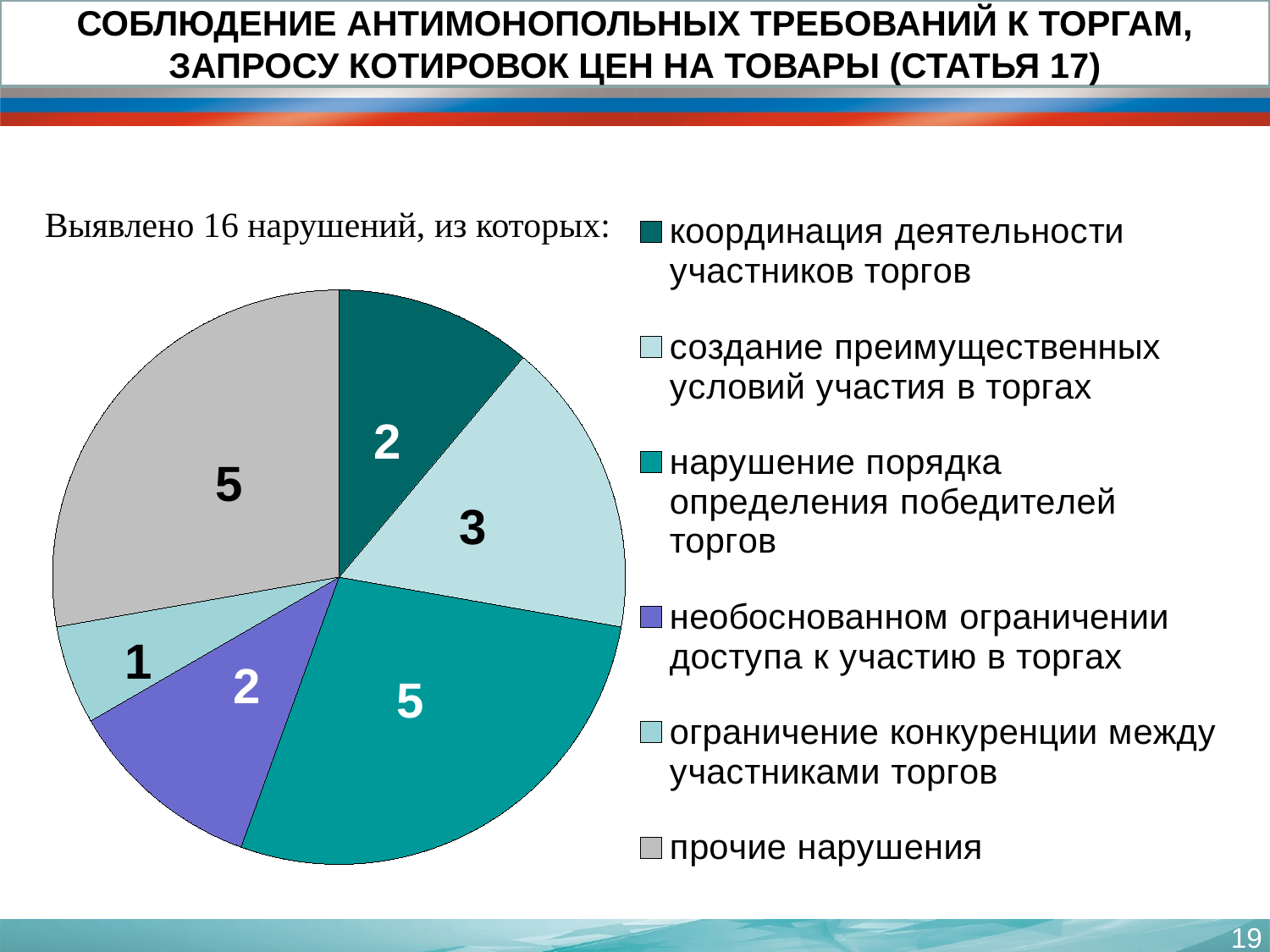
What is the value for "создание преимущественных условий участия в торгах"? 3 What share of the total does the "прочие нарушения" slice represent? 31.25% What is the difference between the values for "прочие нарушения" and "создание преимущественных условий участия в торгах"? 2 How many slices does the pie chart have? 6 How many entries does the legend list? 6 What is the value for "ограничение конкуренции между участниками торгов"? 1 What is the value for "нарушение порядка определения победителей торгов"? 5 What kind of chart is shown on the slide? pie chart Which is larger: the value for "необоснованном ограничении доступа к участию в торгах" or the value for "создание преимущественных условий участия в торгах"? создание преимущественных условий участия в торгах Which category has the smallest slice in the pie chart? ограничение конкуренции между участниками торгов What colour is the slice for "необоснованном ограничении доступа к участию в торгах"? purple What is the value for "координация деятельности участников торгов"? 2